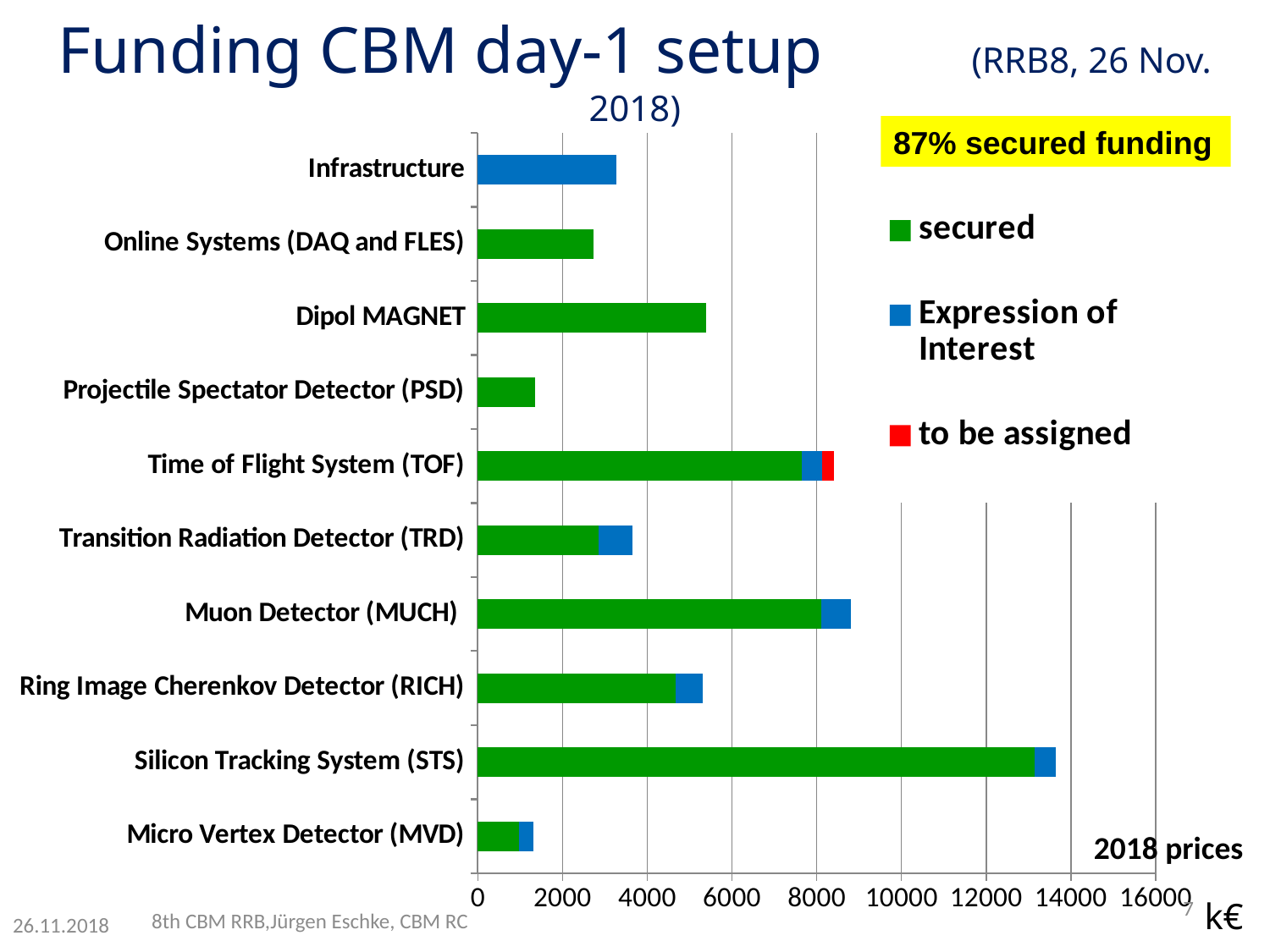
Is the total value for Silicon Tracking System (STS) greater or less than 12000? greater Is the total value for Transition Radiation Detector (TRD) greater or less than 4000? less Which category's bar consists only of the Expression of Interest (blue) series? Infrastructure Which category has the longest bar overall? Silicon Tracking System (STS) Is the value for Infrastructure greater or less than 4000? less Which series is shown in red in the legend? to be assigned How many categories (subsystems) are plotted on the chart? 10 Which has the larger total bar, Muon Detector (MUCH) or Ring Image Cherenkov Detector (RICH)? Muon Detector (MUCH) How many series does the legend list? 3 What kind of chart is shown on the slide? bar chart